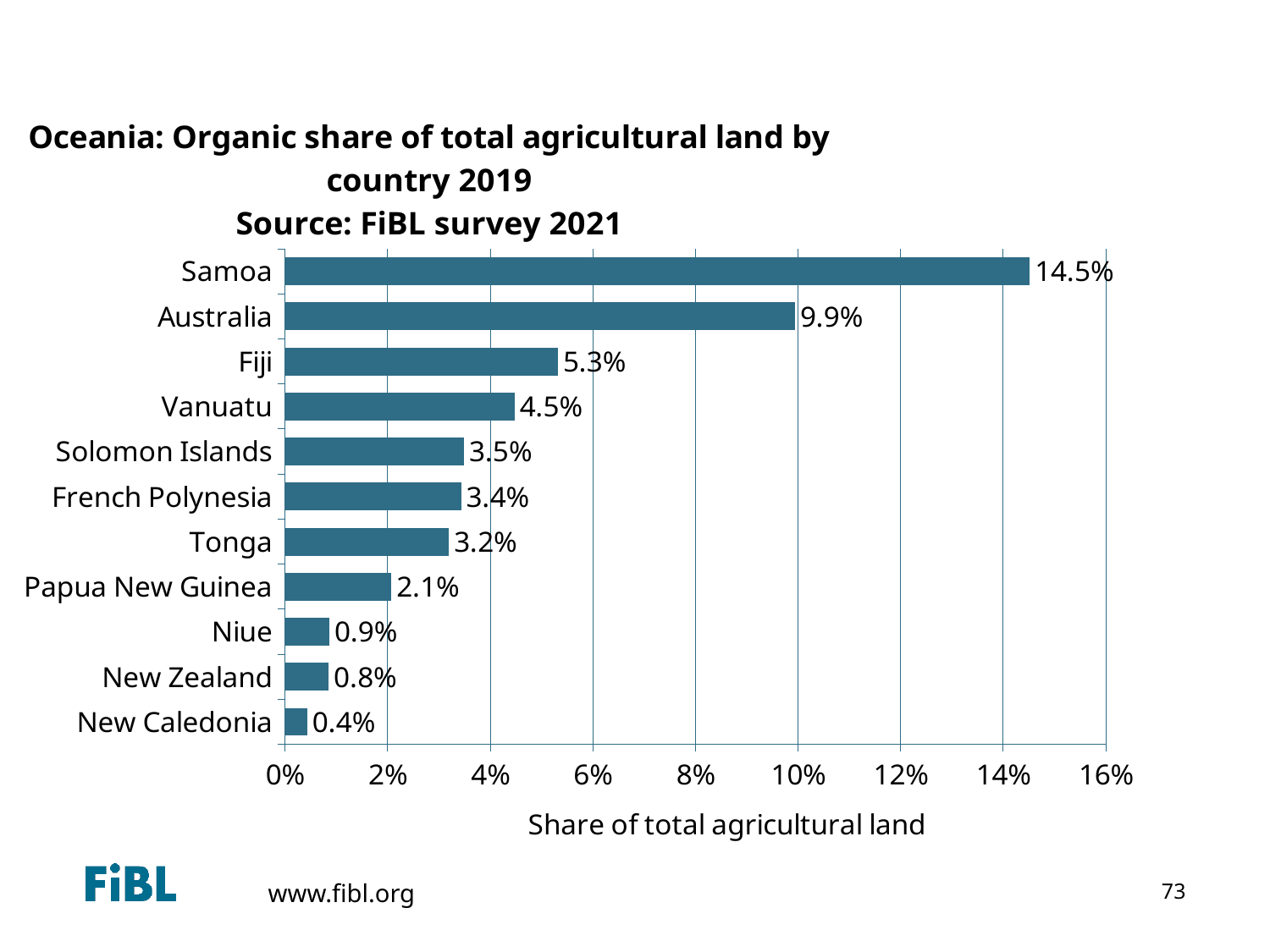
How many countries are shown in the chart? 11 What type of chart is shown on the slide? Bar chart What is the organic share of total agricultural land for Fiji? 5.3% What is the difference in organic share between Samoa and Australia? 4.6% What is the organic share of total agricultural land for Papua New Guinea? 2.1% What is the label of the horizontal axis? Share of total agricultural land What is the organic share of total agricultural land for Samoa? 14.5% Which country has the lowest organic share of total agricultural land? New Caledonia Which has a larger organic share of agricultural land, Fiji or Vanuatu? Fiji Is the value for Australia greater or less than 8%? greater What is the difference in organic share between Vanuatu and Tonga? 1.3% Which country has the highest organic share of total agricultural land? Samoa